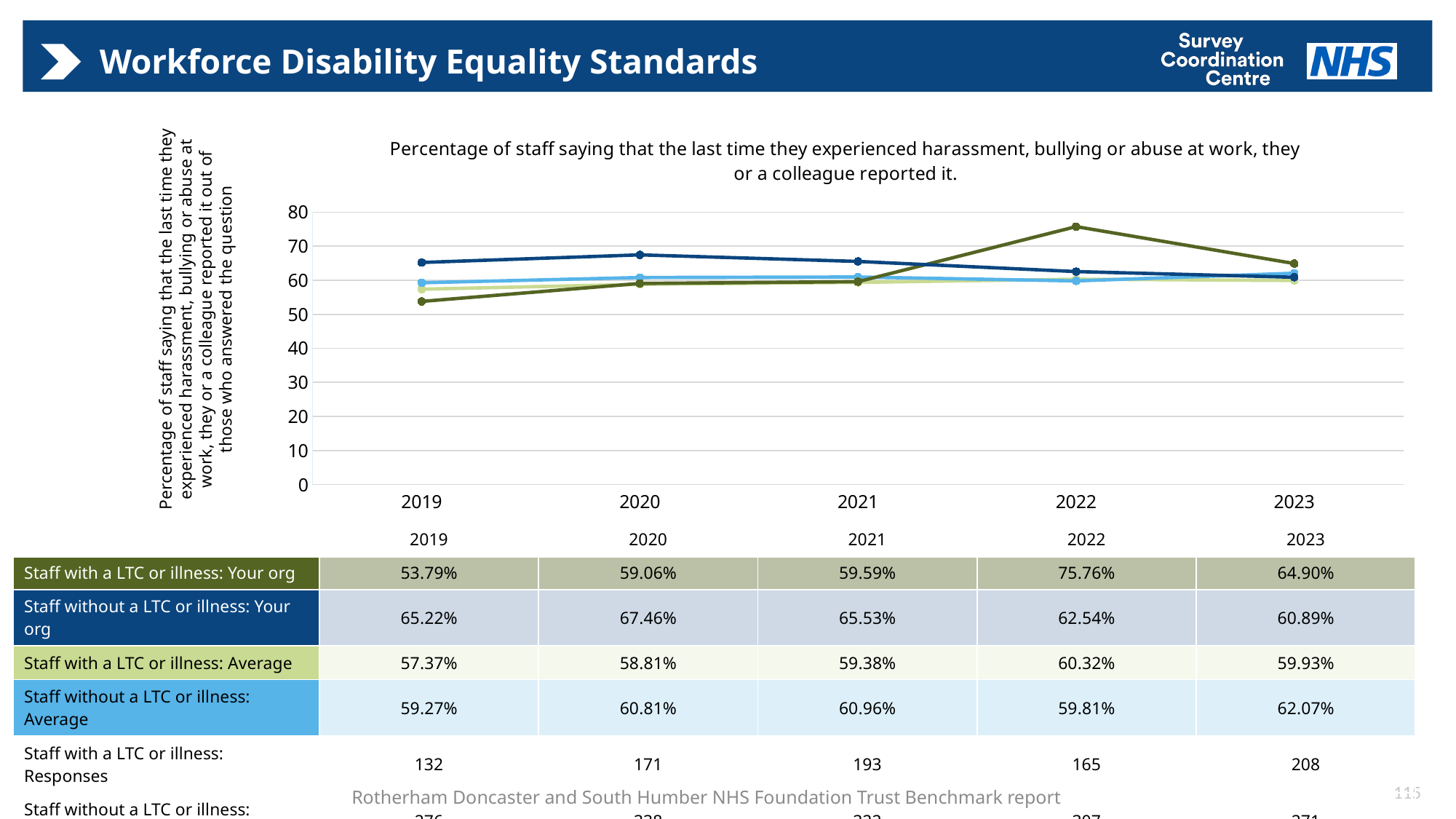
How many years are shown on the x axis of the chart? 5 What kind of chart is shown on the slide? line chart What is the value for Staff with a LTC or illness: Your org in 2022? 75.76% What is the value for Staff with a LTC or illness: Average in 2023? 59.93% What is the difference between Staff with a LTC or illness: Your org and Staff without a LTC or illness: Your org in 2022? 13.22 percentage points In 2020, which is larger: Staff with a LTC or illness: Your org or Staff without a LTC or illness: Your org? Staff without a LTC or illness: Your org Does the value for Staff without a LTC or illness: Your org rise or fall from 2020 to 2023? fall What is the value for Staff without a LTC or illness: Your org in 2019? 65.22% How many data series are plotted in the chart? 4 In which year is the value for Staff with a LTC or illness: Your org lowest? 2019 In which year is the value for Staff with a LTC or illness: Your org highest? 2022 Is the value for Staff with a LTC or illness: Your org in 2022 greater or less than 70? greater